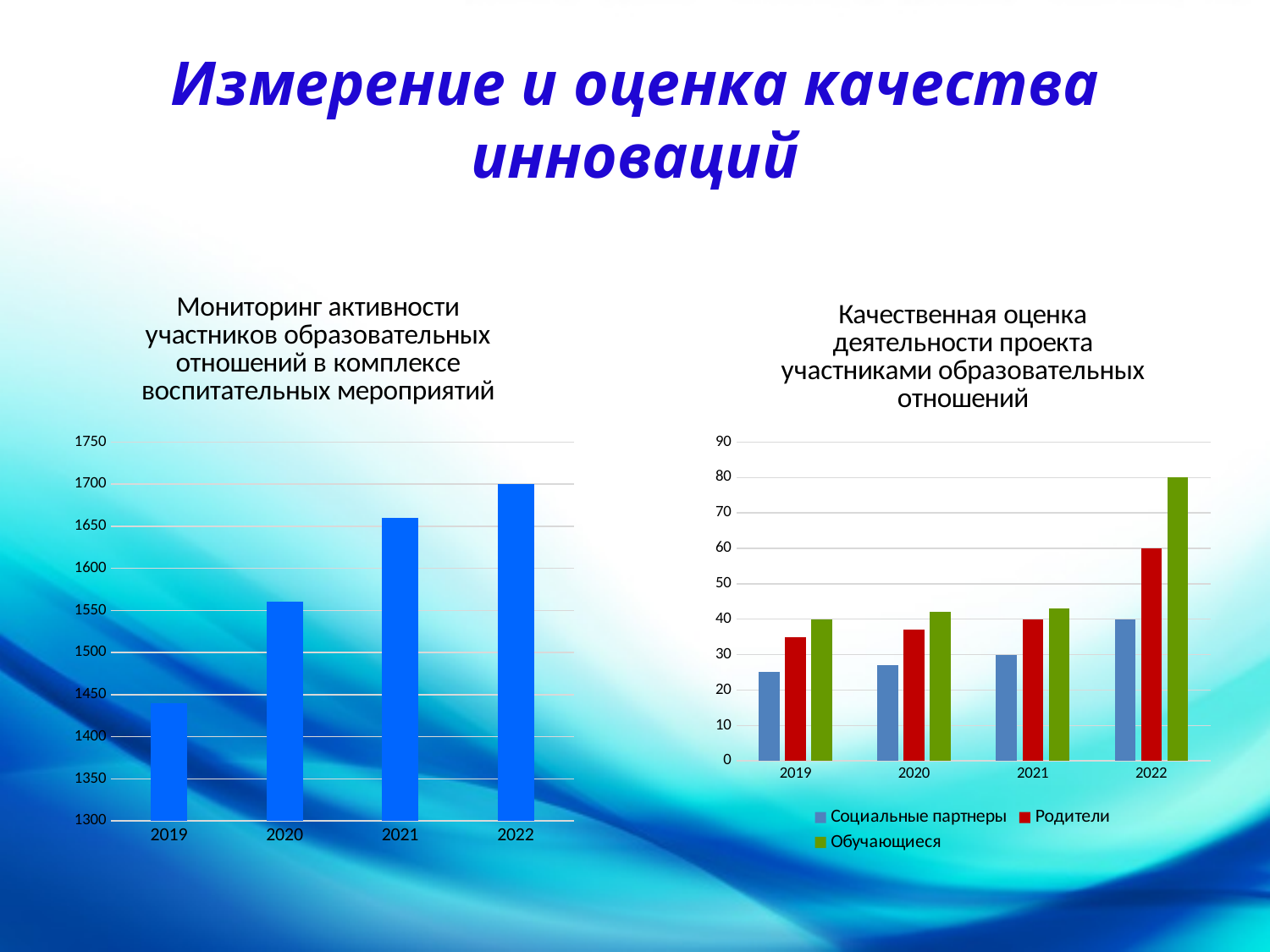
What kind of chart is the left chart titled "Мониторинг активности участников образовательных отношений в комплексе воспитательных мероприятий"? bar chart In the right chart (Качественная оценка деятельности проекта...), what is the value for Родители in 2022? 60 In the left chart (Мониторинг активности...), do the values rise or fall from 2019 to 2022? rise In the left chart (Мониторинг активности...), is the value for 2019 greater or less than 1500? less How many years are shown on the x axis of the left chart (Мониторинг активности...)? 4 In the left chart (Мониторинг активности...), which year has the highest value? 2022 In the right chart (Качественная оценка деятельности проекта...), what is the value for Обучающиеся in 2022? 80 In the right chart (Качественная оценка деятельности проекта...), which series has the highest value in 2022? Обучающиеся In the right chart (Качественная оценка деятельности проекта...), is the value for Социальные партнеры in 2019 greater or less than 30? less In the left chart (Мониторинг активности...), which year has the lowest value? 2019 How many series does the legend of the right chart (Качественная оценка деятельности проекта...) list? 3